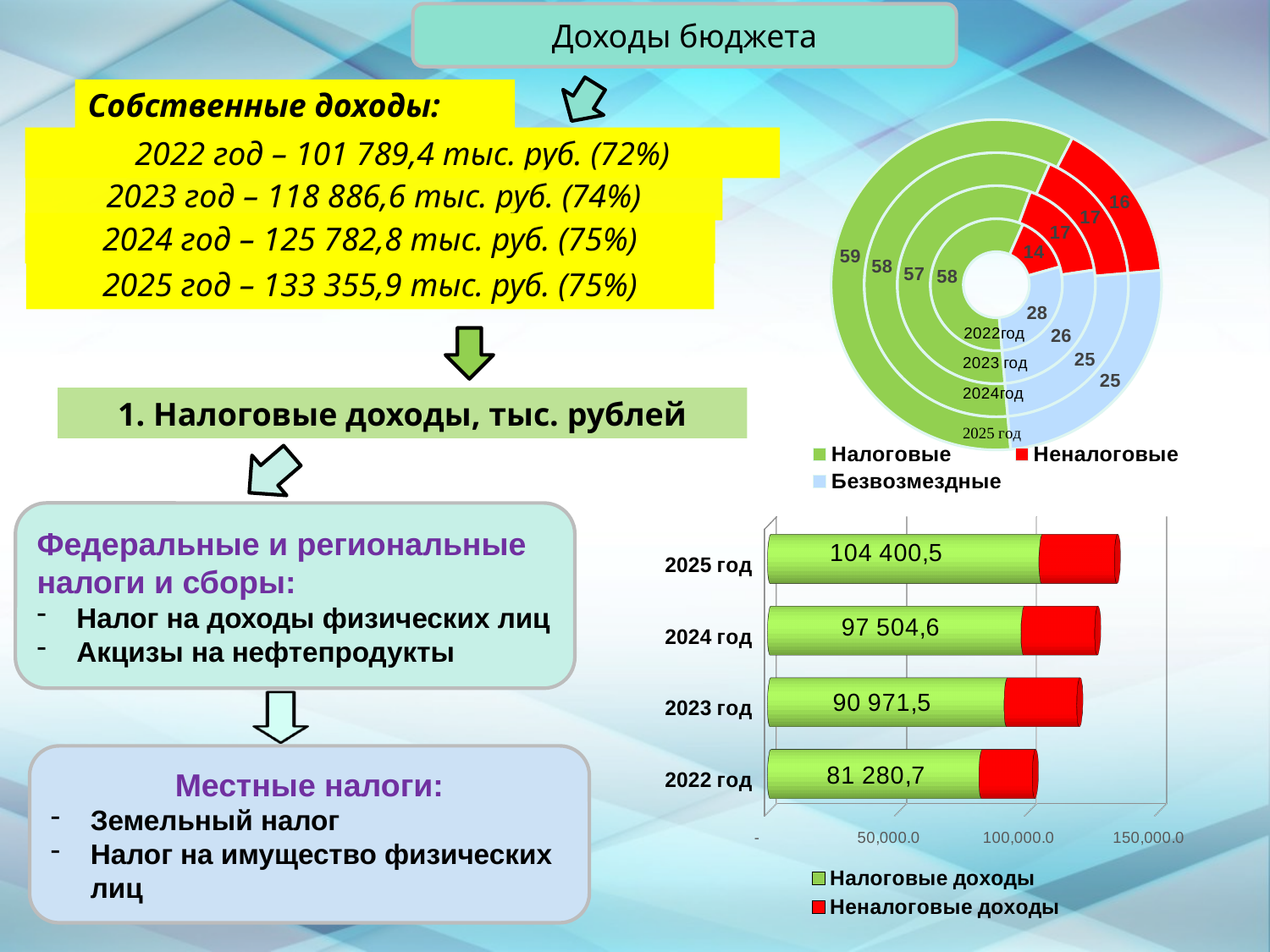
In the bar chart at the bottom right, what is the value of Налоговые доходы for 2022 год? 81 280,7 What kind of chart is shown at the bottom right of the slide? bar chart In the bar chart at the bottom right, how many series does the legend list? 2 In the bar chart at the bottom right, which year has the highest Налоговые доходы? 2025 год In the doughnut chart at the top right, how many series does the legend list? 3 In the bar chart at the bottom right, do Налоговые доходы rise or fall from 2022 год to 2025 год? rise In the bar chart at the bottom right, what is the value of Налоговые доходы for 2025 год? 104 400,5 In the doughnut chart at the top right, what is the Налоговые share for 2025 год? 59 In the bar chart at the bottom right, what is the difference between Налоговые доходы in 2024 год and 2023 год? 6 533,1 In the bar chart at the bottom right, what is the value of Налоговые доходы for 2023 год? 90 971,5 In the doughnut chart at the top right, what is the Неналоговые share for 2022 год? 14 In the doughnut chart at the top right, what is the Безвозмездные share for 2023 год? 26